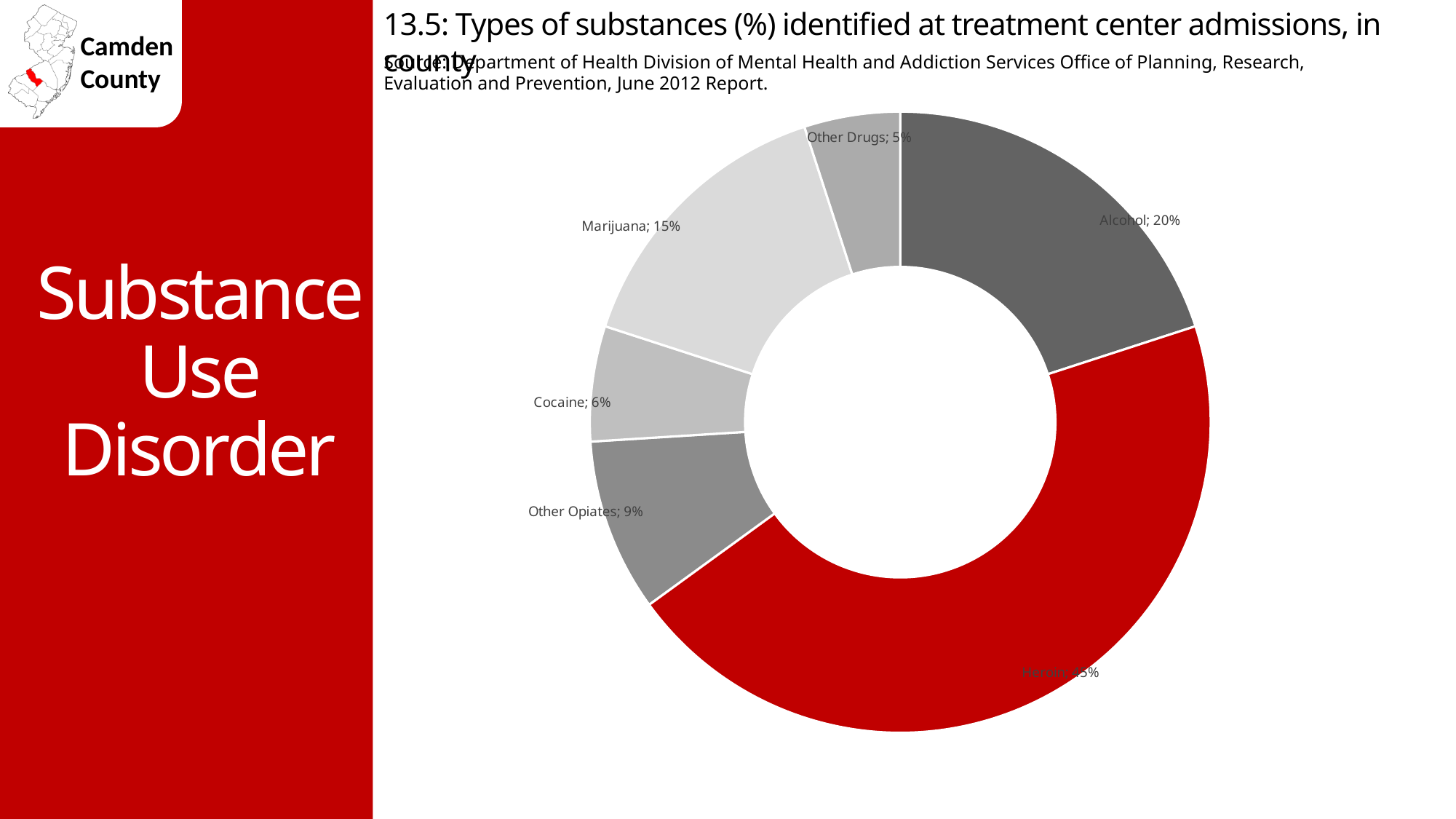
What percentage is shown for Alcohol? 20% What is the difference in percentage points between Alcohol and Marijuana? 5 What percentage is shown for Other Opiates? 9% Which substance has the smallest share of treatment center admissions? Other Drugs Which substance has the largest share of treatment center admissions? Heroin What percentage is shown for Cocaine? 6% Which substance category is shown in red? Heroin What percentage is shown for Marijuana? 15% Which has a larger share, Other Opiates or Cocaine? Other Opiates How many substance categories are shown in the chart? 6 What percentage is shown for Other Drugs? 5% What type of chart is shown on the slide? Doughnut chart